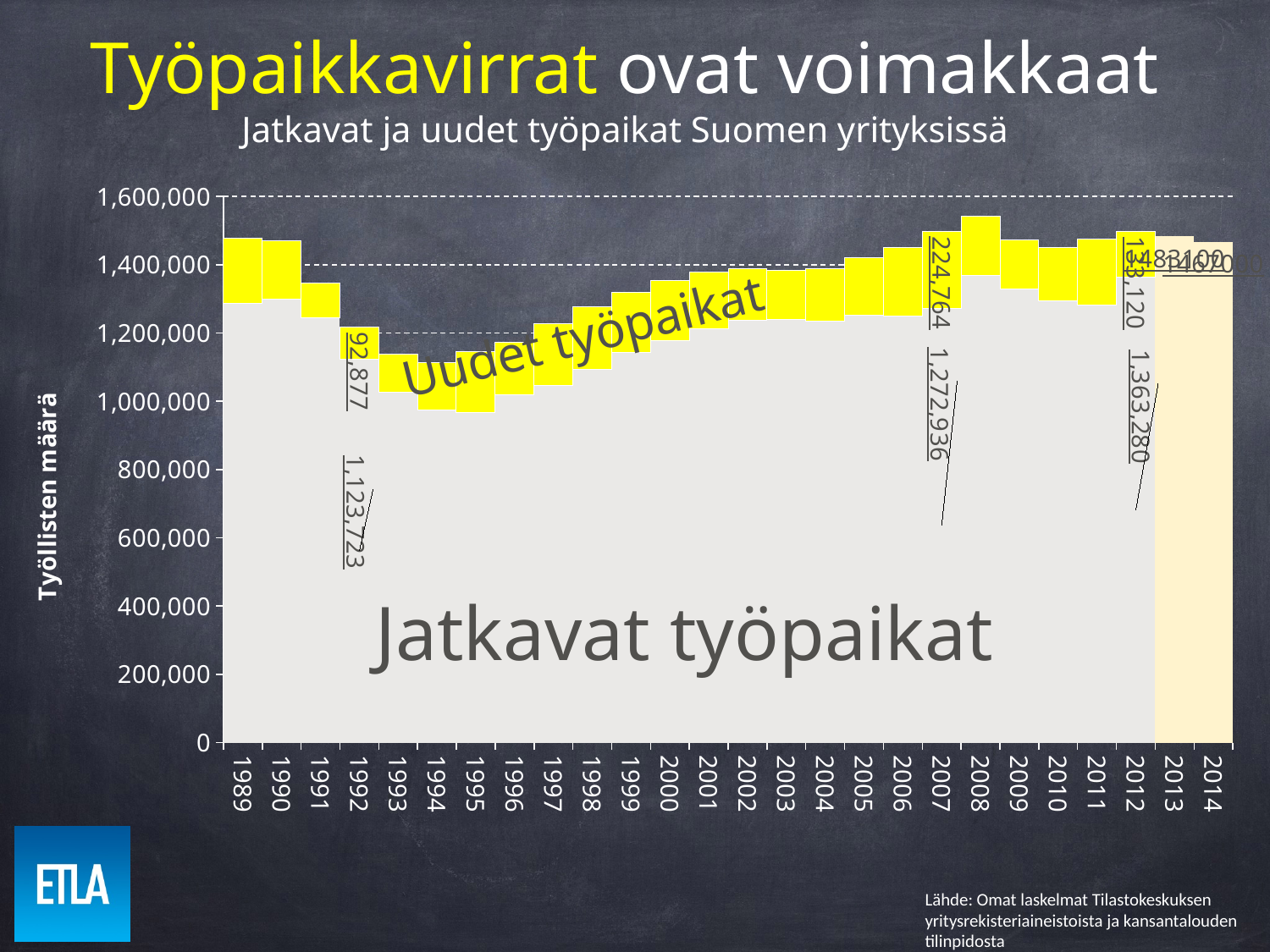
How many years are shown on the x axis? 26 Which is larger, Jatkavat työpaikat in 2012 or in 2007? 2012 What kind of chart is shown on the slide? Stacked bar chart What is the total of the stacked bar for 2007 (Jatkavat työpaikat plus Uudet työpaikat)? 1,497,700 Is the total value for 2008 greater or less than 1,400,000? greater What is the value for Jatkavat työpaikat in 2012? 1,363,280 What is the difference between Uudet työpaikat in 2007 and in 1992? 131,887 Is the total value for 1994 greater or less than 1,200,000? less Does the total number of jobs rise or fall from 1989 to 1994? Fall What is the value for Uudet työpaikat in 2007? 224,764 What is the value for Uudet työpaikat in 1992? 92,877 What is the value for Jatkavat työpaikat in 1992? 1,123,723